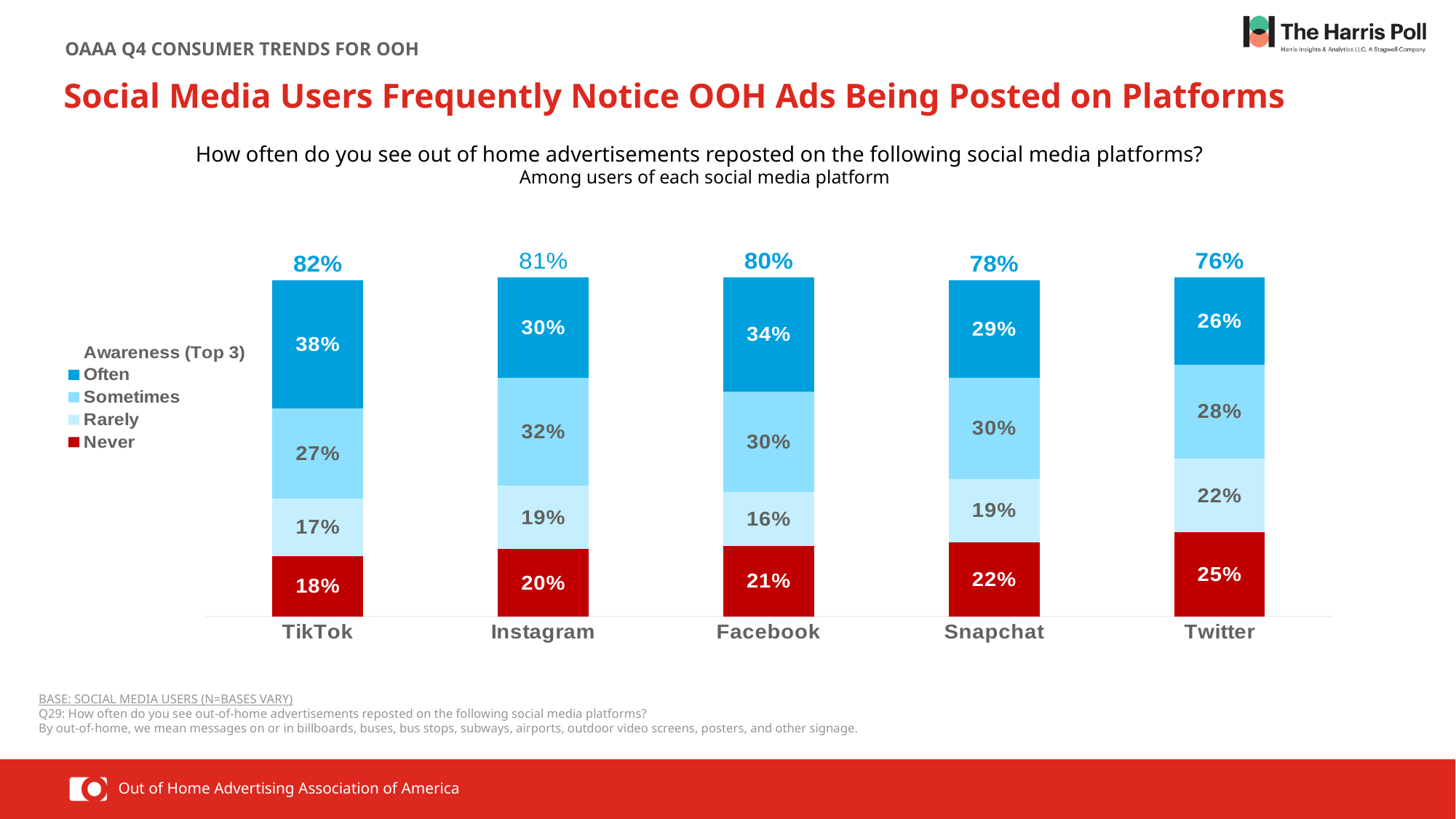
What is the 'Often' value for TikTok? 38% What is the 'Sometimes' value for Instagram? 32% Which is larger: the 'Rarely' value for Twitter or the 'Rarely' value for Facebook? Twitter Do the Awareness (Top 3) figures rise or fall from TikTok to Twitter along the x axis? Fall What kind of chart is shown on the slide? Stacked bar chart What is the difference between the 'Never' values for Twitter and TikTok? 7% What is the 'Never' value for Twitter? 25% What is the Awareness (Top 3) figure shown above the Facebook bar? 80% Which platform has the highest 'Often' value? TikTok How many social media platforms are shown on the x axis? 5 Which platform has the lowest Awareness (Top 3) figure? Twitter